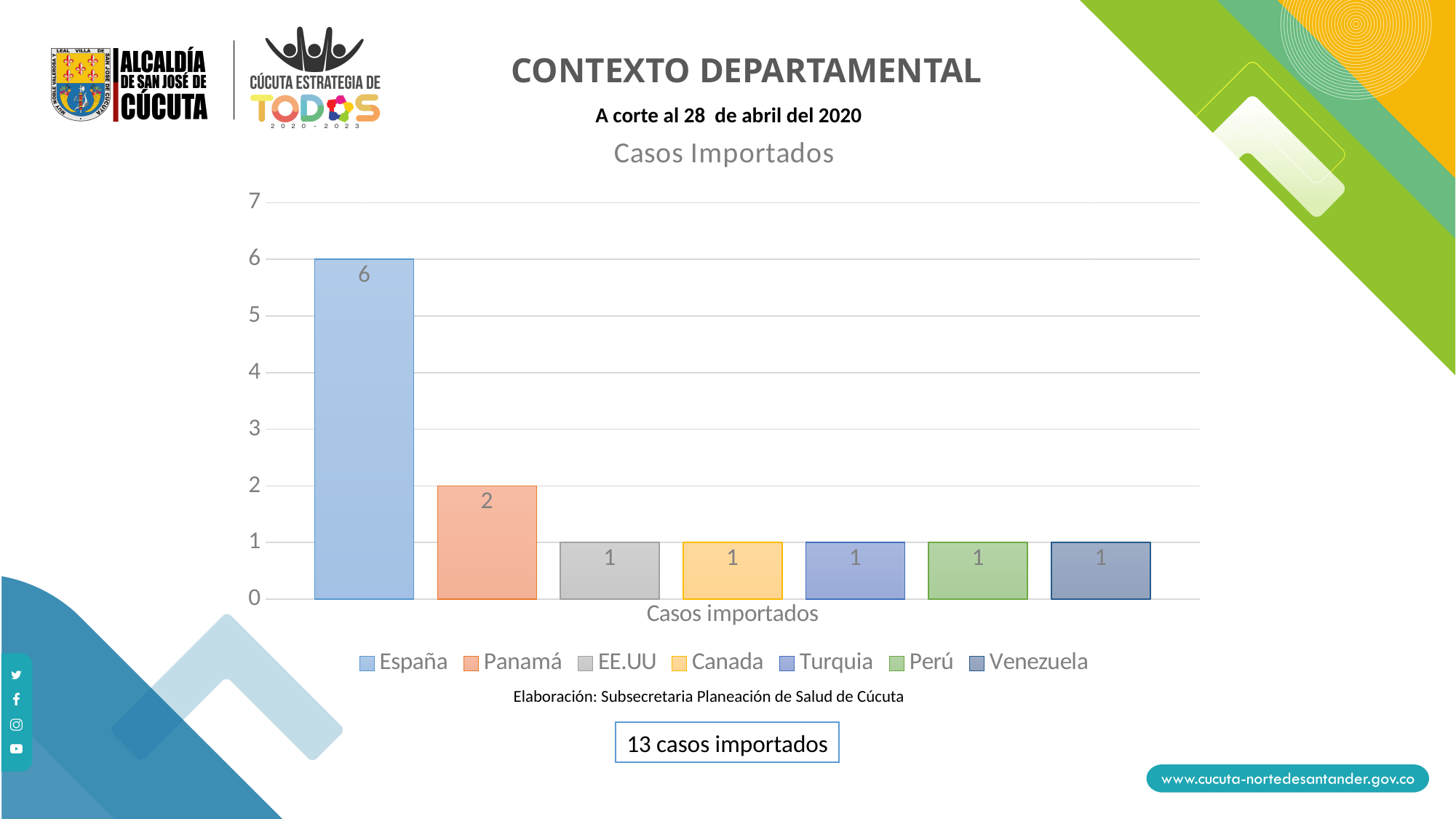
What is the total of all the values shown in the chart? 13 How many series does the legend of the Casos Importados chart list? 7 What is the difference between the values for España and Panamá? 4 Which country has the highest number of imported cases in the chart? España Is the value for España greater or less than 5? greater What is the title of the chart on the slide? Casos Importados How many countries have a value of 1 in the chart? 5 What is the value for Panamá in the Casos Importados chart? 2 What is the value for Venezuela in the Casos Importados chart? 1 What is the value for España in the Casos Importados chart? 6 What kind of chart is shown on the slide? bar chart Which is larger, the value for Panamá or the value for Canada? Panamá